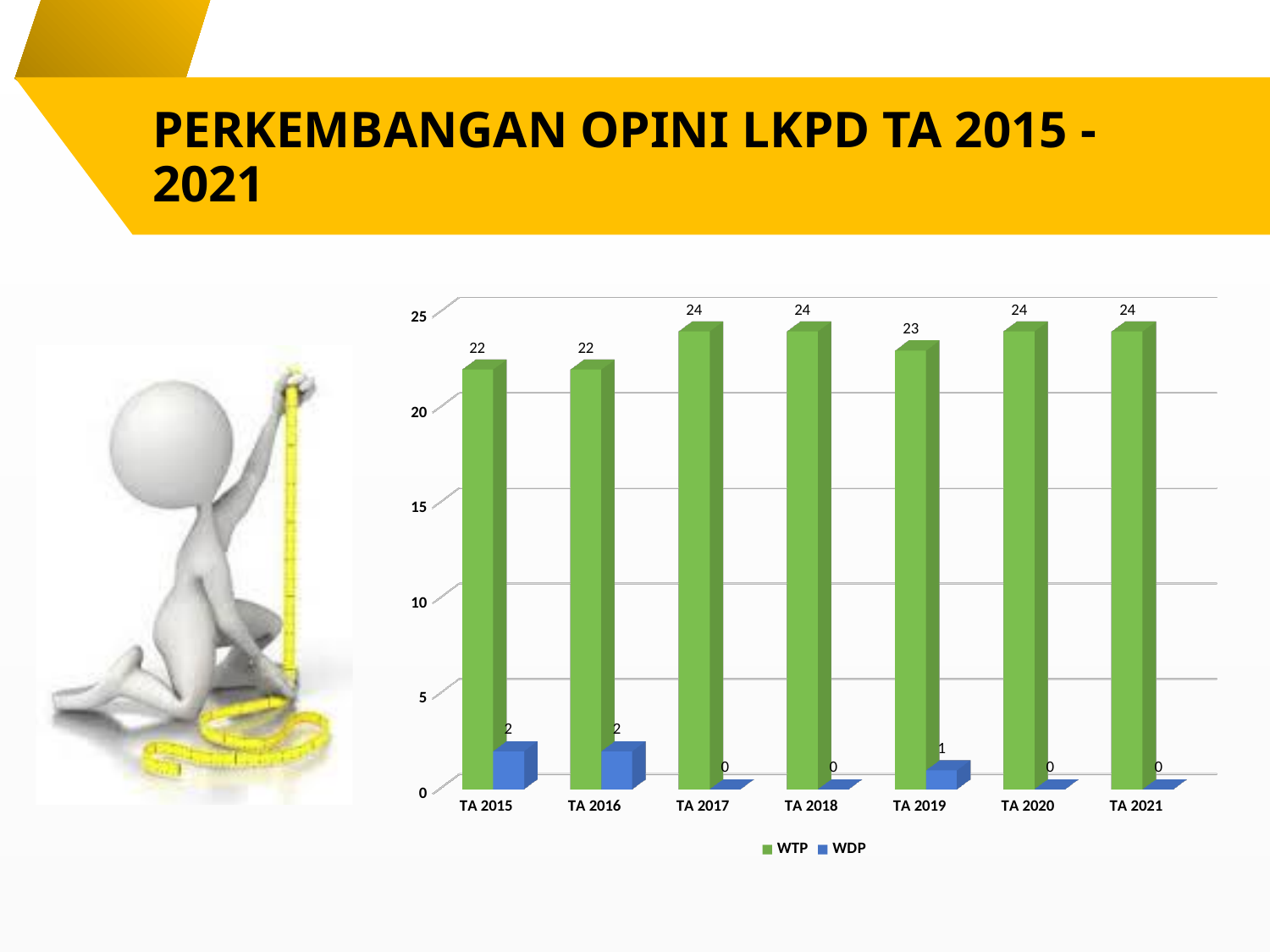
What kind of chart is shown on the slide? Bar chart What is the total of WTP and WDP for TA 2016? 24 How many series does the legend list? 2 Which is larger, the WTP value for TA 2018 or the WTP value for TA 2019? TA 2018 What is the WDP value for TA 2015? 2 Which colour represents the WDP series? Blue Which year has the lowest WTP value? TA 2015 and TA 2016 What is the difference between the WTP value for TA 2017 and the WTP value for TA 2015? 2 What is the WDP value for TA 2019? 1 What is the WTP value for TA 2019? 23 What is the WTP value for TA 2021? 24 How many years are shown on the x axis? 7